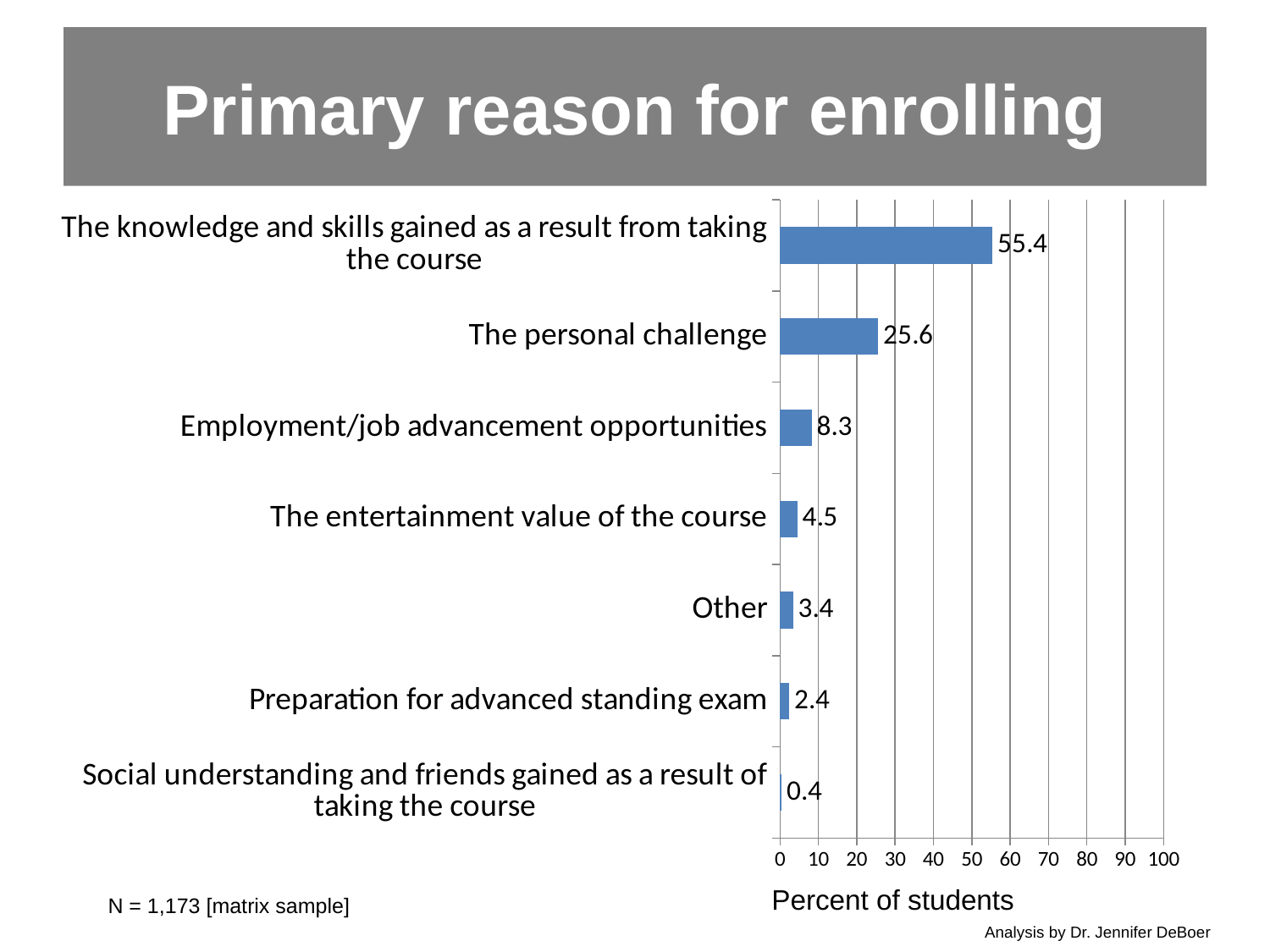
What percent of students chose 'The personal challenge' as their primary reason for enrolling? 25.6 What is the difference between the values for 'The knowledge and skills gained as a result from taking the course' and 'The personal challenge'? 29.8 Which is larger: the value for 'Employment/job advancement opportunities' or 'The entertainment value of the course'? Employment/job advancement opportunities What kind of chart is shown on the slide? Bar chart How many reasons for enrolling are shown in the chart? 7 Which reason for enrolling has the highest percent of students? The knowledge and skills gained as a result from taking the course Which reason for enrolling has the lowest percent of students? Social understanding and friends gained as a result of taking the course What is the value for 'Other'? 3.4 What is the value for 'Employment/job advancement opportunities'? 8.3 Is the value for 'The knowledge and skills gained as a result from taking the course' greater or less than 50? greater What is the difference between the values for 'The entertainment value of the course' and 'Preparation for advanced standing exam'? 2.1 What is the label of the horizontal axis? Percent of students